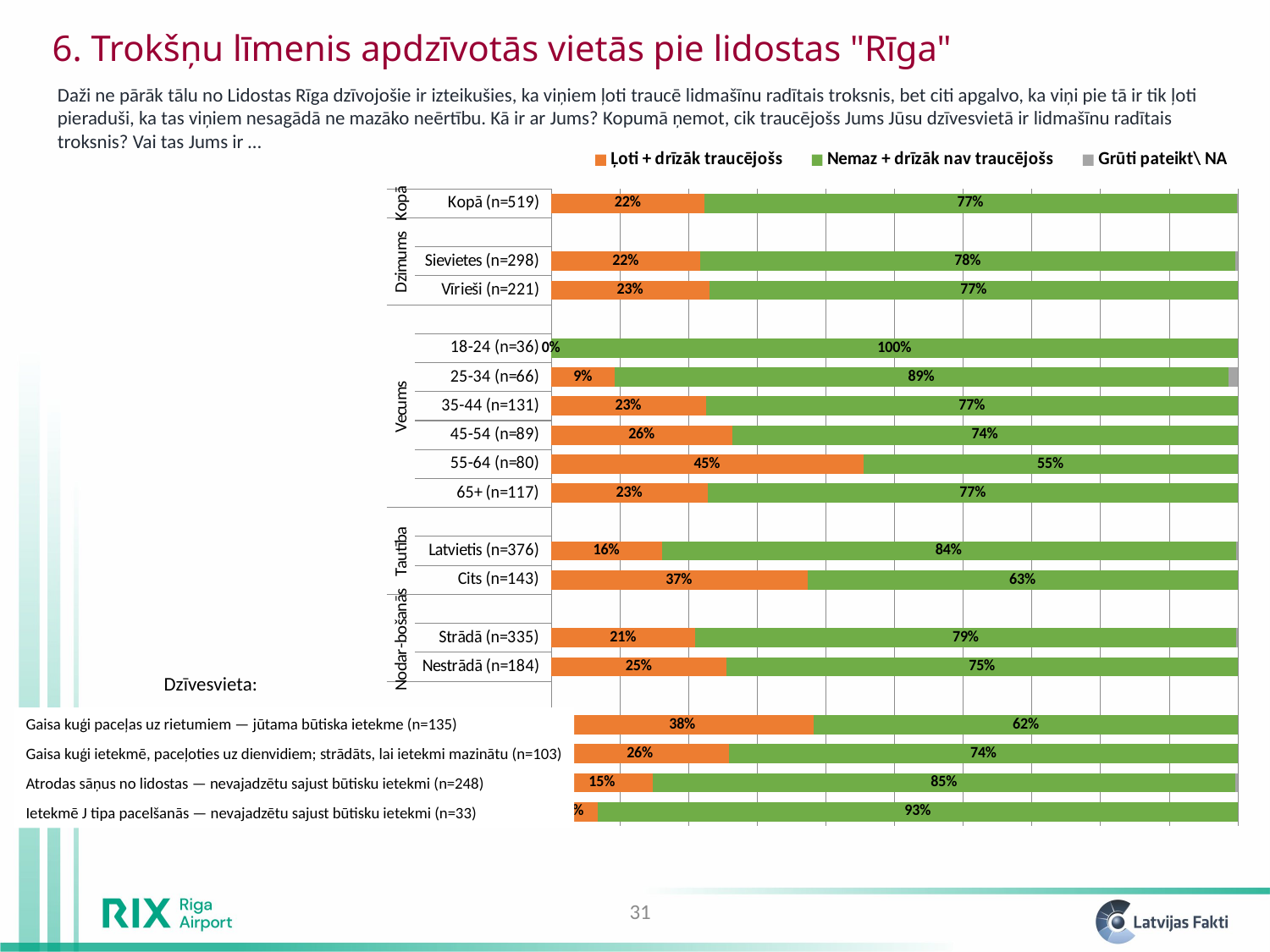
Which has a larger "Ļoti + drīzāk traucējošs" value, Strādā (n=335) or Nestrādā (n=184)? Nestrādā (n=184) What is the difference between the "Ļoti + drīzāk traucējošs" values for Cits (n=143) and Latvietis (n=376)? 21% Which age group has the highest value of "Ļoti + drīzāk traucējošs"? 55-64 (n=80) How many series does the legend list? 3 What is the value of "Nemaz + drīzāk nav traucējošs" for "Atrodas sāņus no lidostas — nevajadzētu sajust būtisku ietekmi (n=248)"? 85% What kind of chart is shown on the slide? Stacked bar chart What is the value of "Nemaz + drīzāk nav traucējošs" for Latvietis (n=376)? 84% What is the value of "Nemaz + drīzāk nav traucējošs" for Sievietes (n=298)? 78% What is the value of "Ļoti + drīzāk traucējošs" for 55-64 (n=80)? 45% What is the value of "Ļoti + drīzāk traucējošs" for Kopā (n=519)? 22% What is the legend entry shown in orange? Ļoti + drīzāk traucējošs Which age group has the lowest value of "Ļoti + drīzāk traucējošs"? 18-24 (n=36)